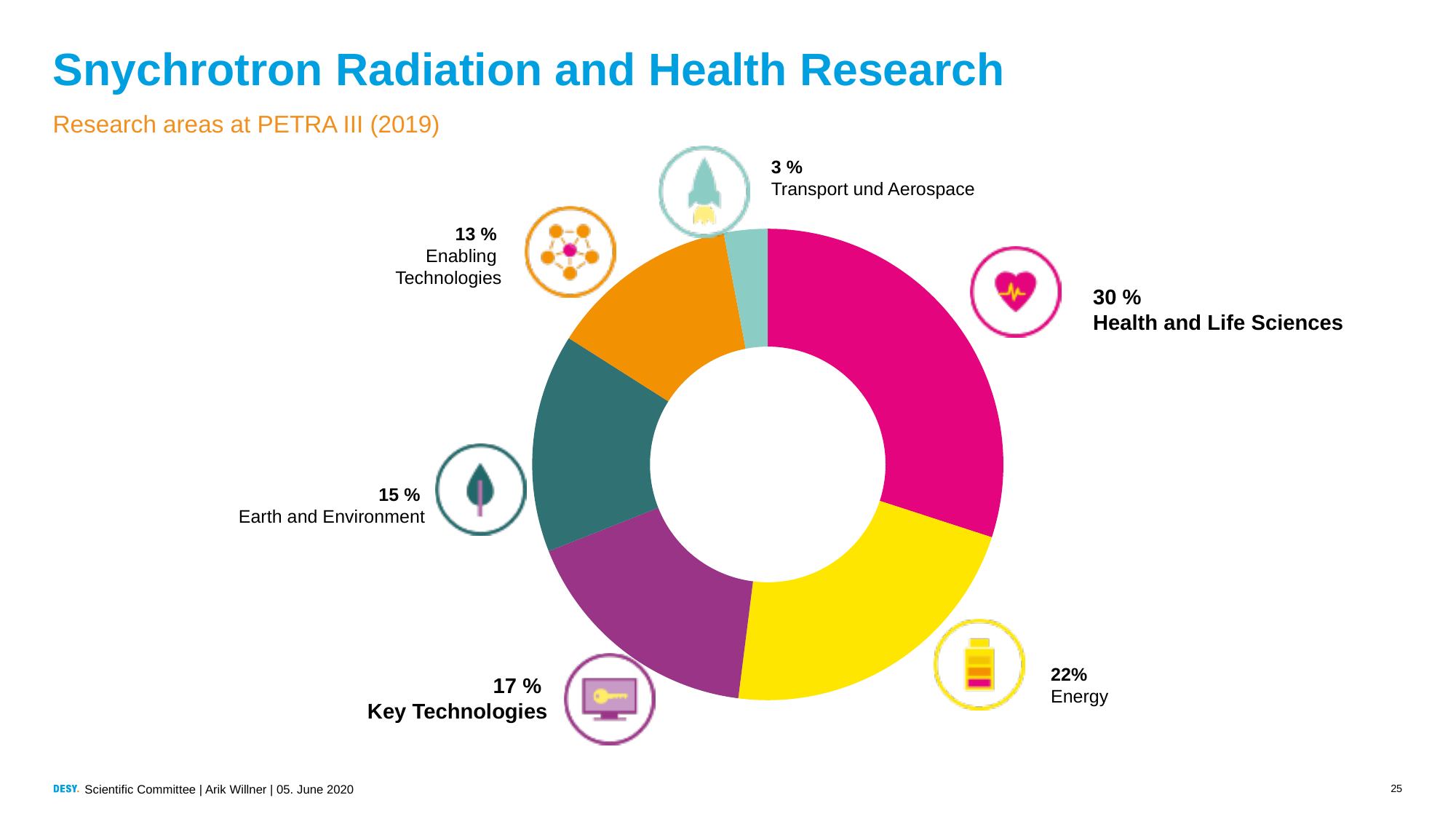
What is the subtitle of the chart on the slide? Research areas at PETRA III (2019) How many research areas are shown in the chart? 6 Which research area has the smallest share of the chart? Transport und Aerospace What share of the chart is Health and Life Sciences? 30 % What kind of chart is shown on the slide? Pie chart (donut) Which has a larger share, Key Technologies or Earth and Environment? Key Technologies Which research area has the largest share of the chart? Health and Life Sciences What share of the chart is Energy? 22% What share of the chart is Enabling Technologies? 13 % What share of the chart is Key Technologies? 17 % What share of the chart is Earth and Environment? 15 % What is the difference in percentage points between Health and Life Sciences and Energy? 8